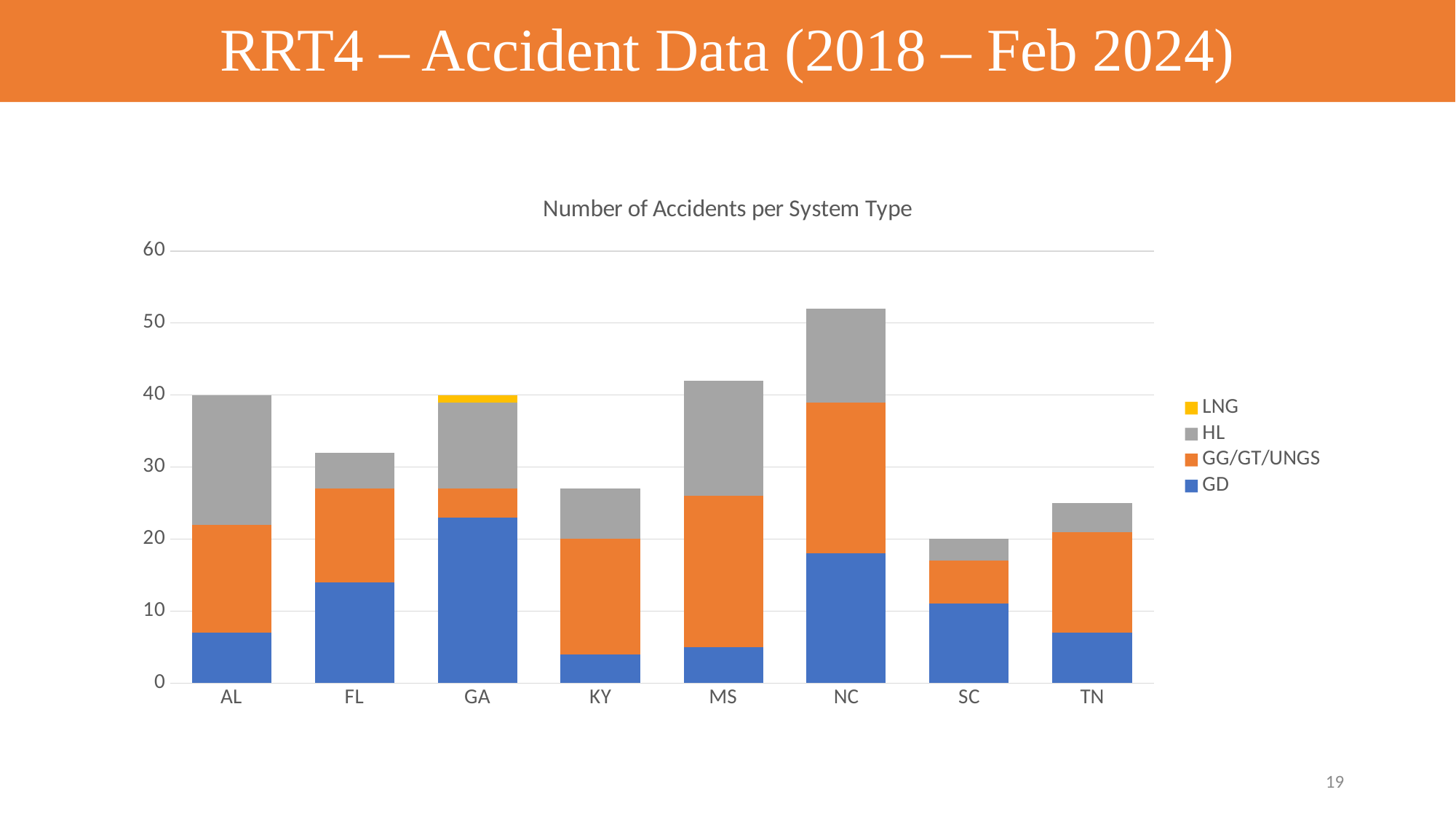
Which state has the larger total, NC or MS? NC Which state has the shortest stacked bar (fewest accidents in total)? SC What kind of chart is shown on the slide? Stacked bar chart Is the total for NC greater or less than 50? greater What is the total height of the stacked bar for SC? 20 How many states are shown on the x axis? 8 Which state has the tallest stacked bar (most accidents in total)? NC How many series does the legend list? 4 Is the GD value for GA greater or less than 20? greater Is the total for KY greater or less than 30? less Which series is shown in yellow in the legend? LNG What is the total height of the stacked bar for AL? 40